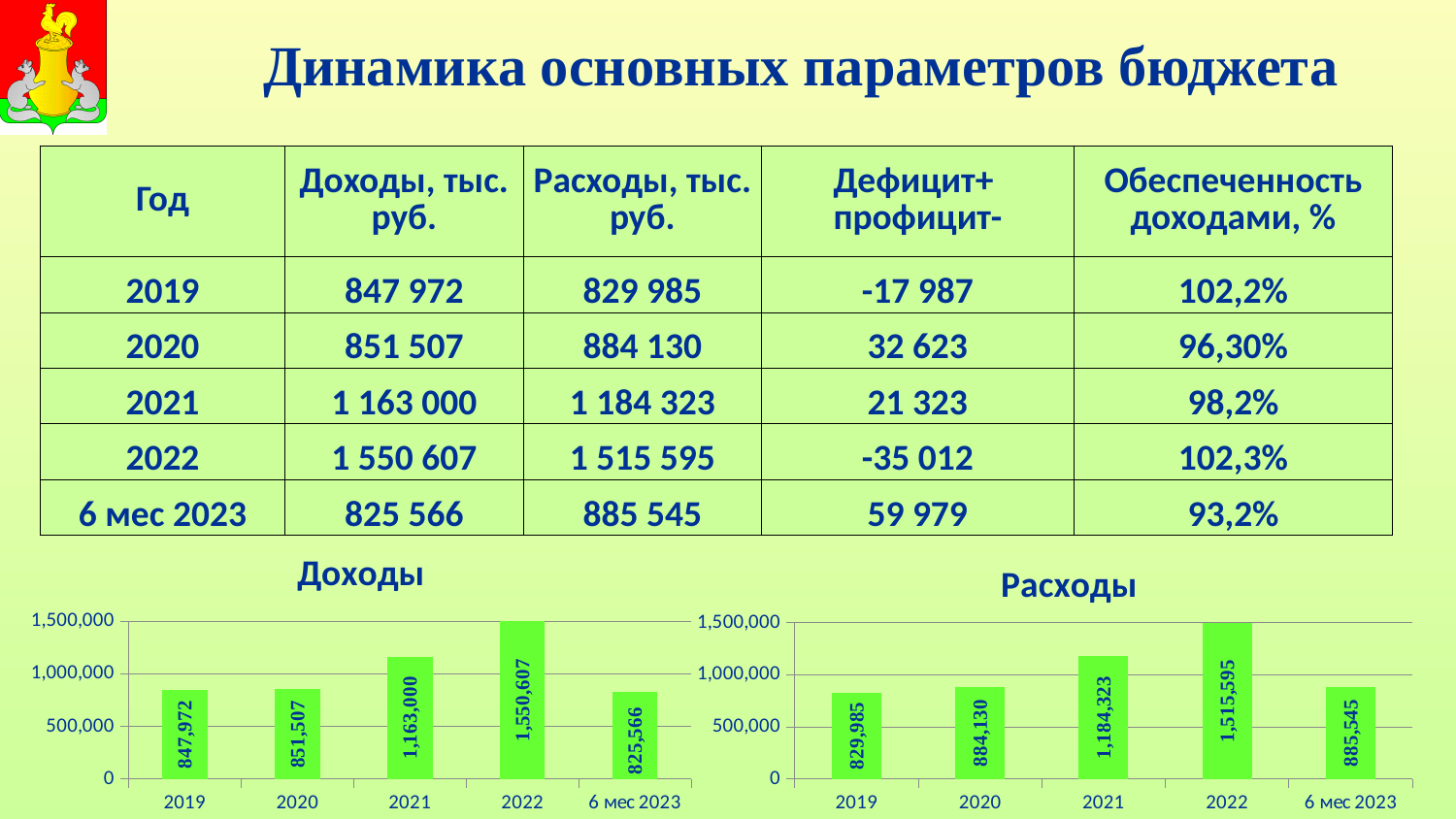
What is the title of the chart on the left side of the slide? Доходы In the "Доходы" chart, what is the value for 2021? 1,163,000 In the "Доходы" chart, which year has the highest value? 2022 In the "Расходы" chart, is the value for 2021 greater or less than 1,000,000? greater In the "Расходы" chart, what is the value for 2020? 884,130 In the "Доходы" chart, what is the difference between the values for 2022 and 2021? 387,607 In the "Доходы" chart, do the values rise or fall from 2019 to 2022? rise In the "Расходы" chart, what is the value for 6 мес 2023? 885,545 How many categories are shown on the x axis of the "Доходы" chart? 5 In the "Расходы" chart, which category has the lowest value? 2019 In the "Расходы" chart, which is larger: the value for 2020 or the value for 6 мес 2023? 6 мес 2023 What kind of chart is the "Расходы" chart? bar chart